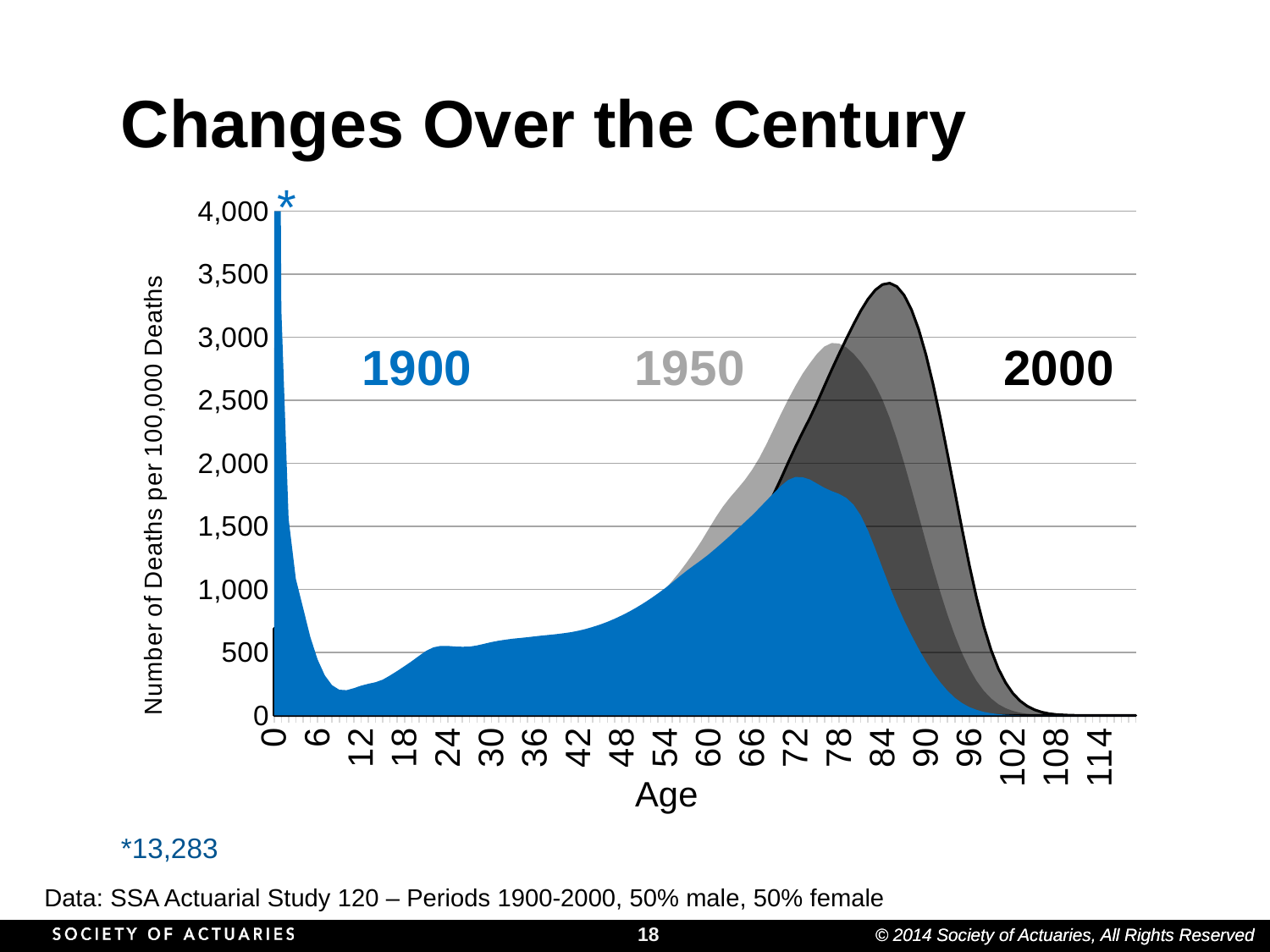
Is the peak value of the 1950 series greater or less than 2,500? greater Which series reaches the highest peak on the chart (excluding the age 0 spike)? 2000 For the 1900 series, do values rise or fall between age 0 and age 6? fall What kind of chart is shown on the slide? area chart Which series has its peak at the oldest age? 2000 How many series (years) are plotted on the chart? 3 At age 84, which series has the larger value, 1900 or 2000? 2000 Is the peak value of the 1900 series at older ages (around age 72) greater or less than 2,000? less According to the asterisk note, what is the number of deaths per 100,000 at age 0 for the 1900 series? 13,283 Is the peak value of the 2000 series greater or less than 3,000? greater What is the title of the x axis? Age What is the title of the y axis? Number of Deaths per 100,000 Deaths